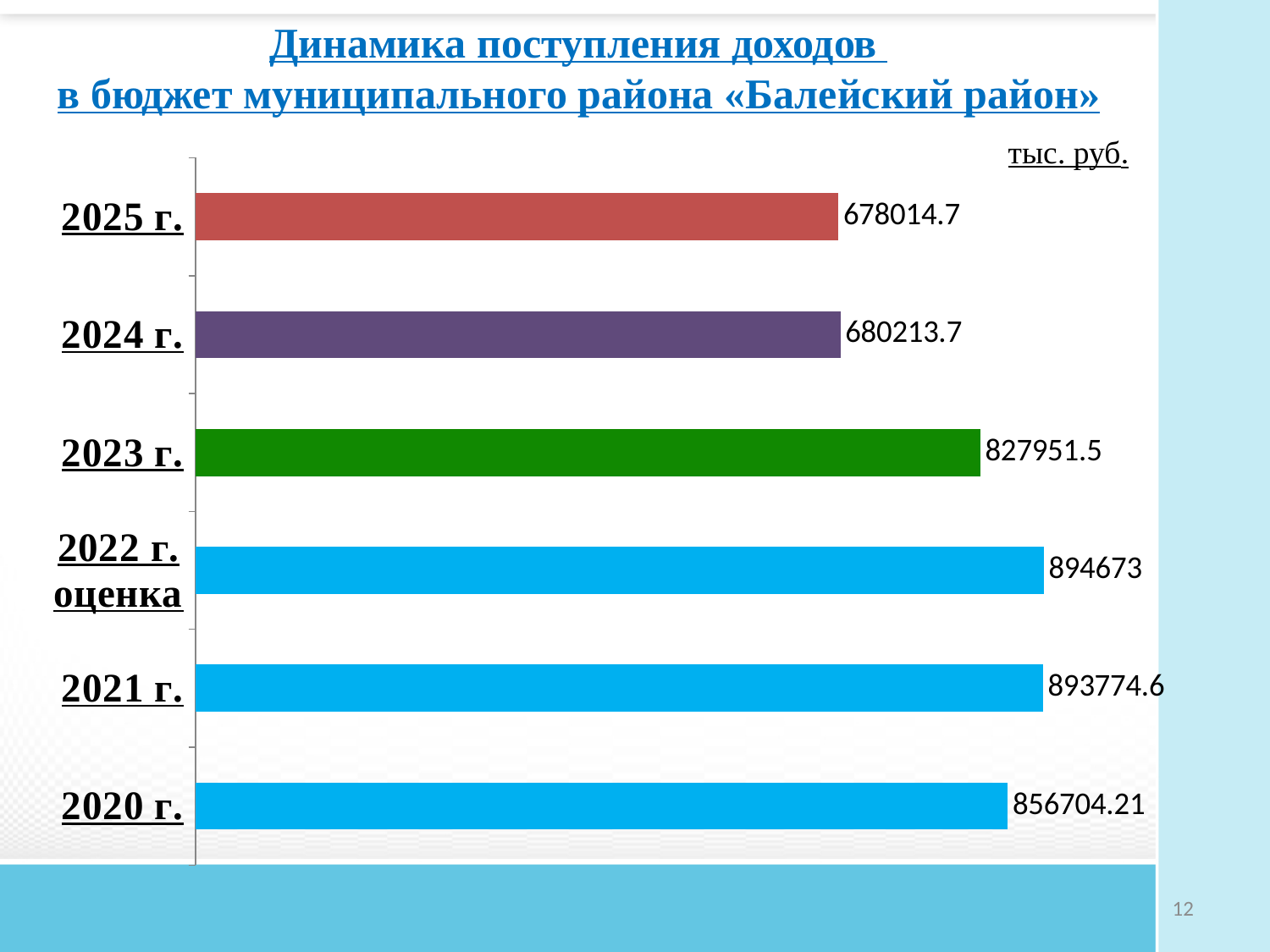
What kind of chart is shown on the slide? bar chart What is the value for 2023 г.? 827951.5 Which is larger, the value for 2023 г. or the value for 2024 г.? 2023 г. Which is larger, the value for 2020 г. or the value for 2025 г.? 2020 г. In what units are the values on the chart given? тыс. руб. What is the value for 2020 г.? 856704.21 What is the value for 2021 г.? 893774.6 What is the value for 2022 г. оценка? 894673 What is the difference between the values for 2023 г. and 2024 г.? 147737.8 What is the value for 2025 г.? 678014.7 How many categories (years) are shown in the chart? 6 What is the difference between the values for 2022 г. оценка and 2025 г.? 216658.3